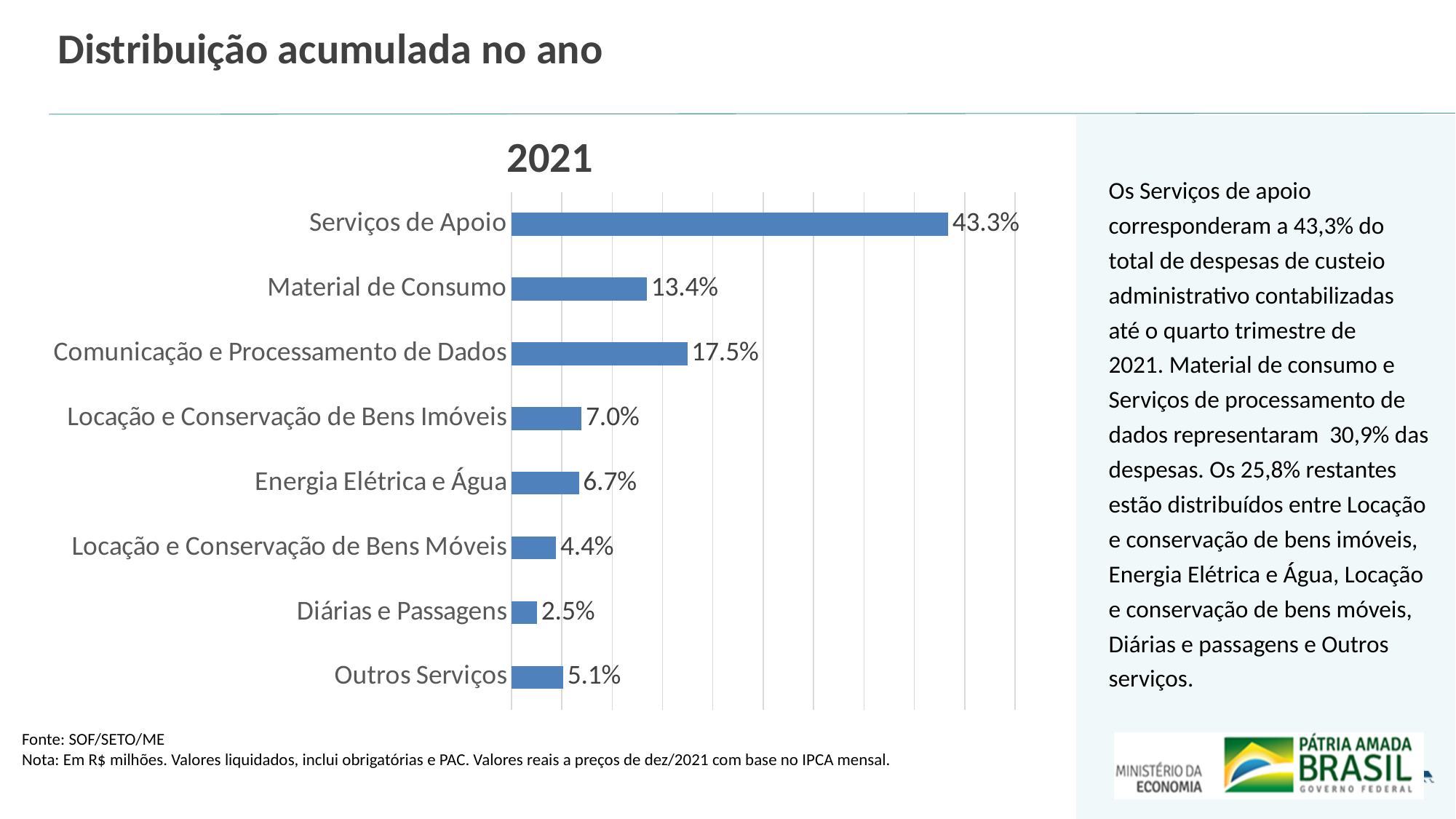
What is the value for Serviços de Apoio? 43.3% What is the value for Comunicação e Processamento de Dados? 17.5% Which category has the highest value? Serviços de Apoio What is the difference between Comunicação e Processamento de Dados and Material de Consumo? 4.1% What is the value for Diárias e Passagens? 2.5% What is the value for Energia Elétrica e Água? 6.7% What is the difference between Serviços de Apoio and Material de Consumo? 29.9% What kind of chart is shown on the slide? Bar chart How many categories are shown in the chart? 8 Which is larger, Outros Serviços or Locação e Conservação de Bens Móveis? Outros Serviços Which category has the lowest value? Diárias e Passagens What is the title of the chart? 2021